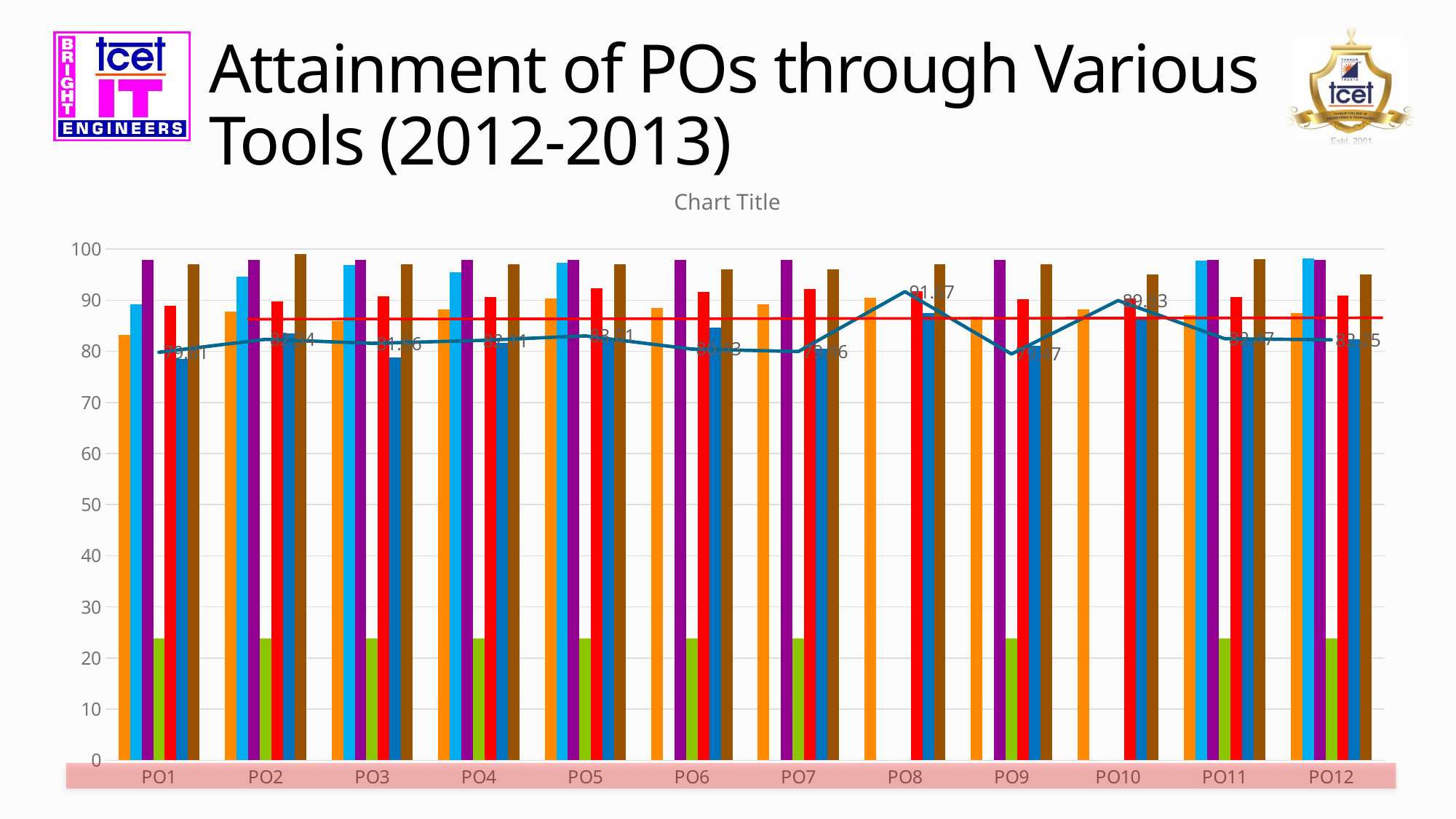
What is the labelled value of the line series at PO10? 89.93 What is the labelled value of the line series at PO9? 79.47 What is the labelled value of the line series at PO8? 91.67 At which PO does the line series reach its highest labelled value? PO8 How many PO categories are shown on the x axis of the chart? 12 Which has the larger line value, PO8 or PO10? PO8 What kind of chart is shown on the slide? A combination bar and line chart What is the difference between the line values at PO8 and PO9? 12.2 Is the value of the green bar at PO1 greater or less than 30? less What title is printed above the chart? Chart Title What is the labelled value of the line series at PO3? 81.56 What is the difference between the line values at PO8 and PO10? 1.74